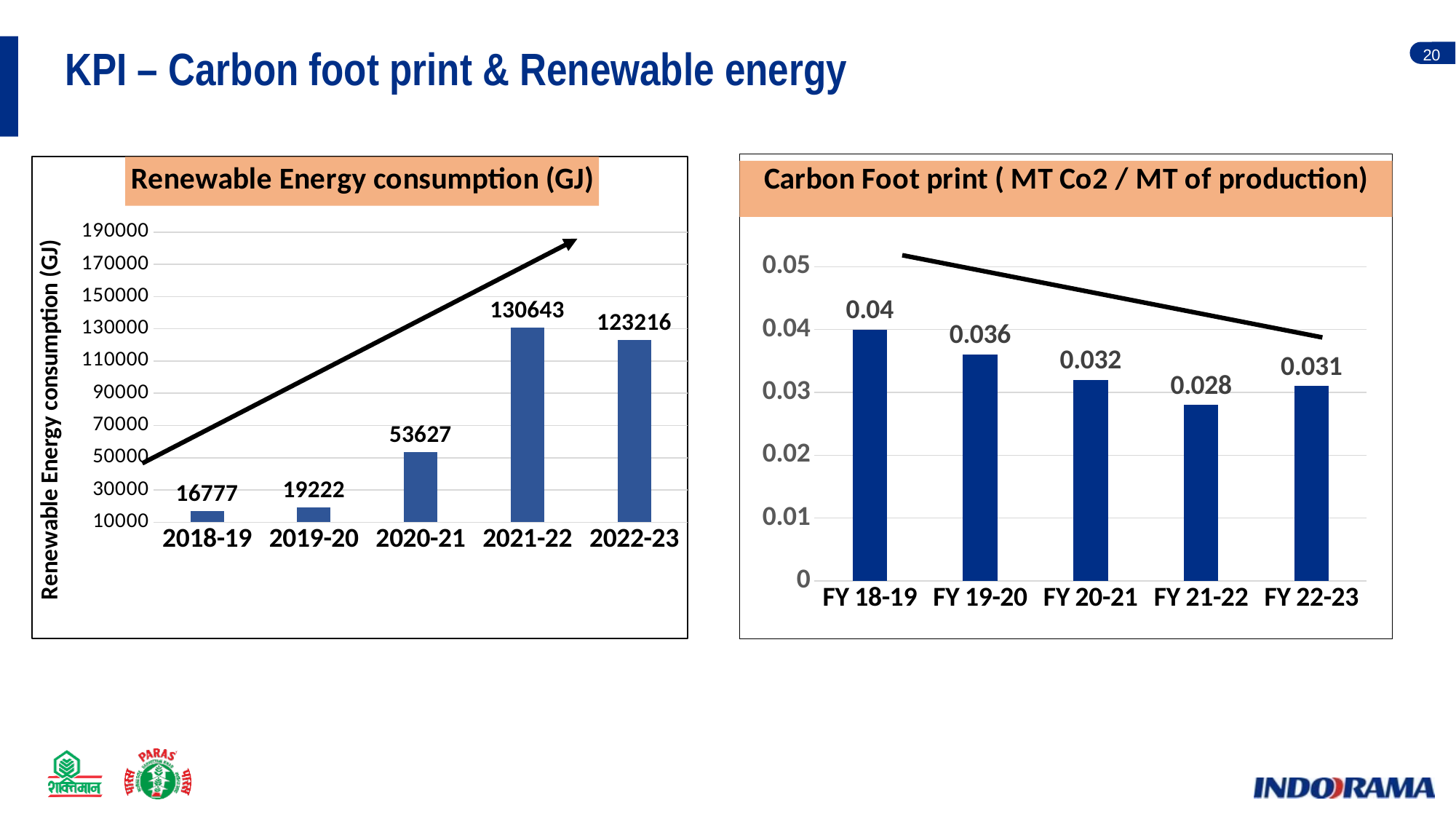
In the Renewable Energy consumption (GJ) chart, what is the value for 2018-19? 16777 In the Renewable Energy consumption (GJ) chart, what is the value for 2021-22? 130643 In the Carbon Foot print chart, which is larger, the value for FY 20-21 or FY 22-23? FY 20-21 In the Renewable Energy consumption (GJ) chart, how many years are shown on the x axis? 5 In the Carbon Foot print chart, which fiscal year has the lowest value? FY 21-22 In the Carbon Foot print chart, what is the difference between the values for FY 18-19 and FY 22-23? 0.009 In the Carbon Foot print chart, what is the value for FY 21-22? 0.028 In the Carbon Foot print chart, what is the value for FY 19-20? 0.036 In the Renewable Energy consumption (GJ) chart, what is the difference between the values for 2021-22 and 2022-23? 7427 In the Renewable Energy consumption (GJ) chart, which year has the highest value? 2021-22 What kind of chart is the Carbon Foot print chart? Bar chart In the Renewable Energy consumption (GJ) chart, which year has the lowest value? 2018-19